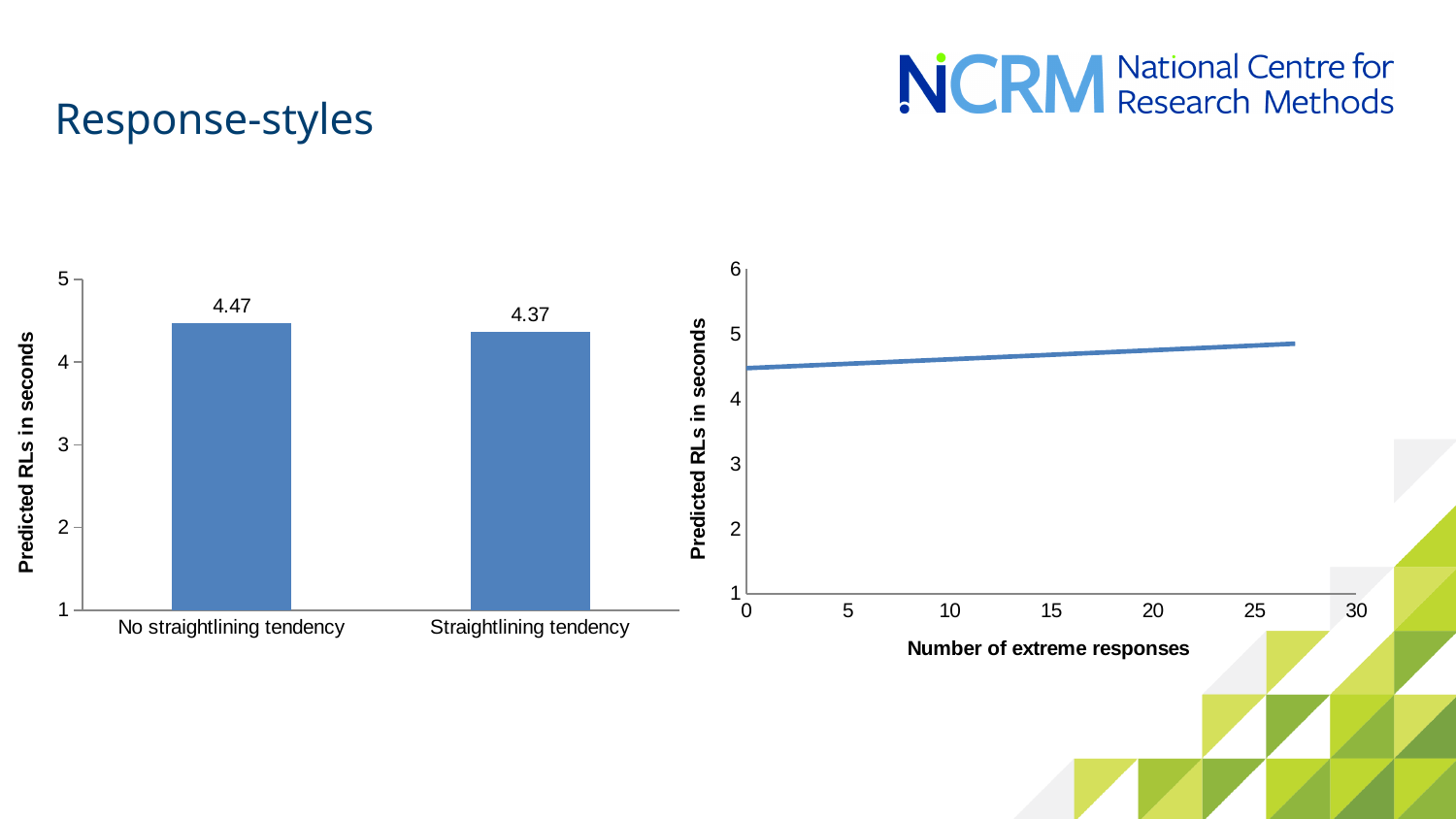
What kind of chart is the chart on the right of the slide? line chart In the chart on the right, is the predicted RL at 0 extreme responses greater or less than 5? less In the bar chart on the left, is the value for 'Straightlining tendency' larger or smaller than the value for 'No straightlining tendency'? smaller In the bar chart on the left, what is the predicted RL in seconds for 'Straightlining tendency'? 4.37 How many categories are shown in the bar chart on the left? 2 What is the x-axis label of the chart on the right? Number of extreme responses In the bar chart on the left, which category has the higher predicted RL? No straightlining tendency What kind of chart is the chart on the left of the slide? bar chart In the bar chart on the left, which category has the lower predicted RL? Straightlining tendency In the bar chart on the left, what is the difference between the predicted RLs for 'No straightlining tendency' and 'Straightlining tendency'? 0.10 In the bar chart on the left, what is the predicted RL in seconds for 'No straightlining tendency'? 4.47 In the chart on the right, do predicted RLs rise or fall as the number of extreme responses increases? rise